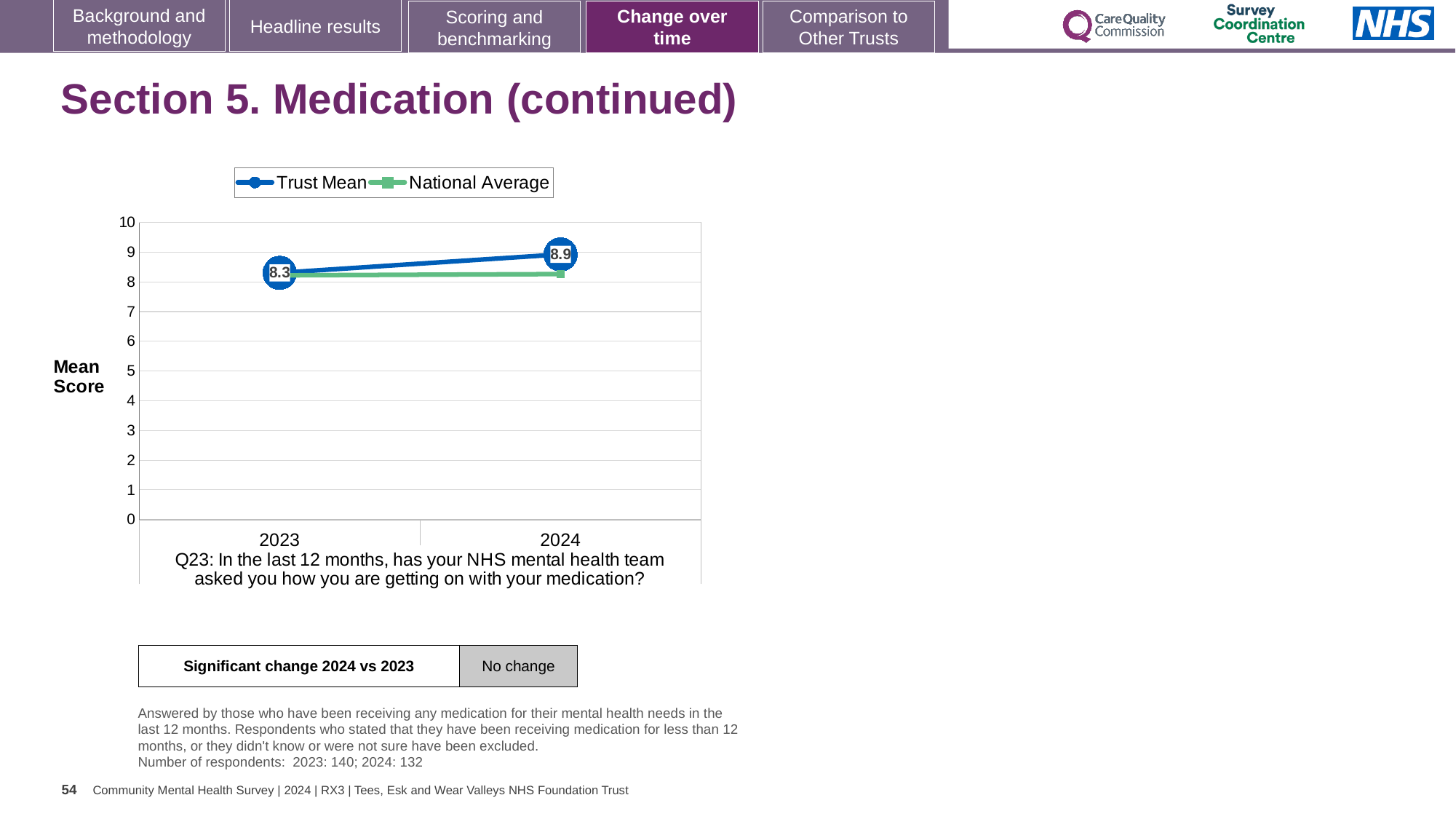
What is the label on the y axis of the chart? Mean Score What is the Trust Mean value for 2024? 8.9 Is the National Average value for 2023 greater or less than 7? greater By how much did the Trust Mean change from 2023 to 2024? 0.6 How many series does the legend list? 2 How many years are shown on the x axis of the chart? 2 What is the Trust Mean value for 2023? 8.3 Which year has the higher Trust Mean, 2023 or 2024? 2024 What kind of chart is shown on the slide? line chart Is the National Average value for 2024 greater or less than 9? less In 2024, which series is higher, Trust Mean or National Average? Trust Mean Does the Trust Mean rise or fall from 2023 to 2024? rise